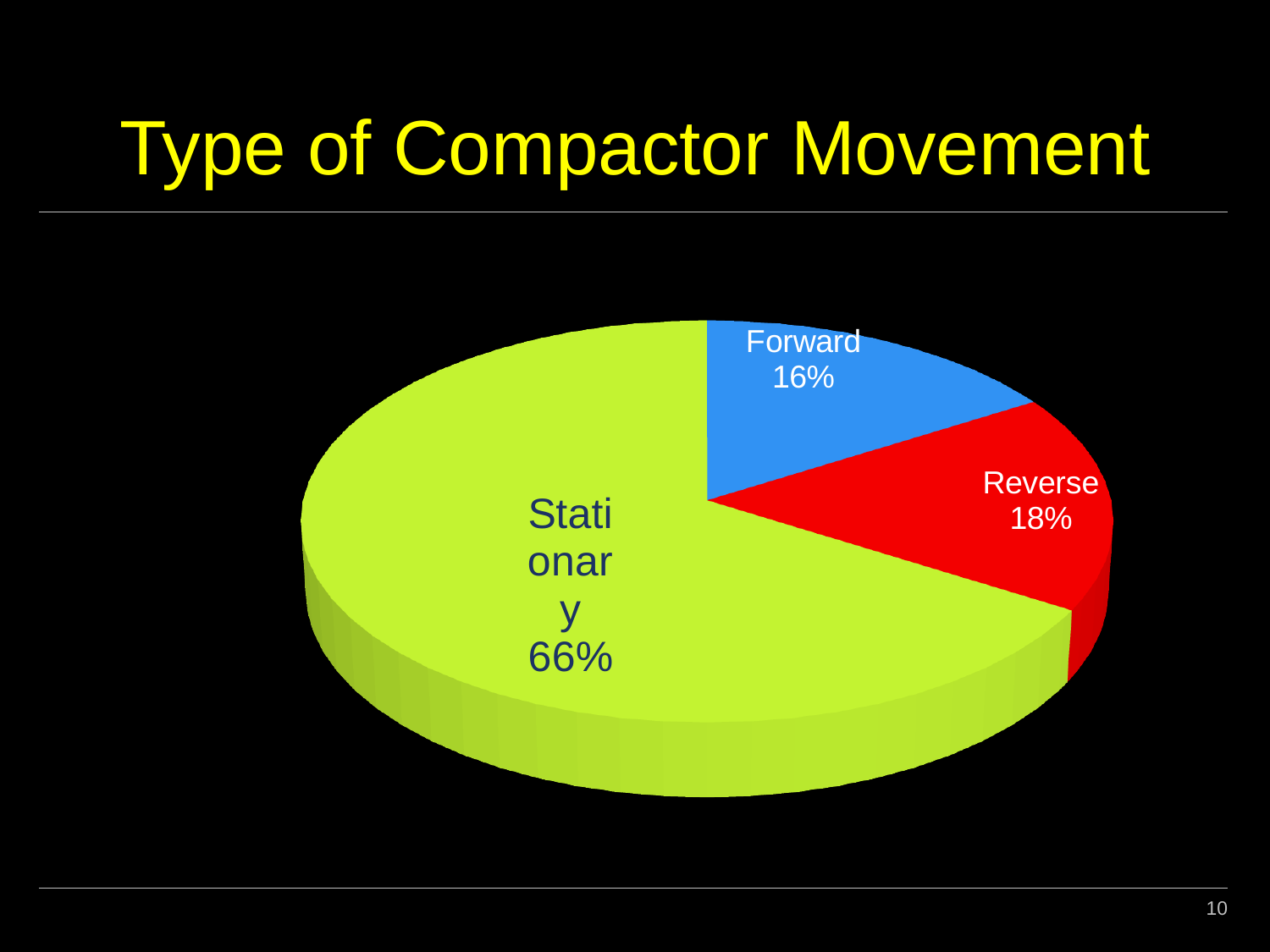
What kind of chart is shown on the slide? Pie chart How many slices does the pie chart have? 3 What colour is the Reverse slice? Red Which type of compactor movement has the largest share? Stationary What share of the pie does Reverse represent? 18% What is the difference in percentage points between the Reverse and Forward shares? 2 What is the title of the slide? Type of Compactor Movement Which has a larger share, Reverse or Forward? Reverse What share of the pie does Forward represent? 16% What share of the pie does Stationary represent? 66% Which type of compactor movement has the smallest share? Forward What is the difference in percentage points between the Stationary and Reverse shares? 48